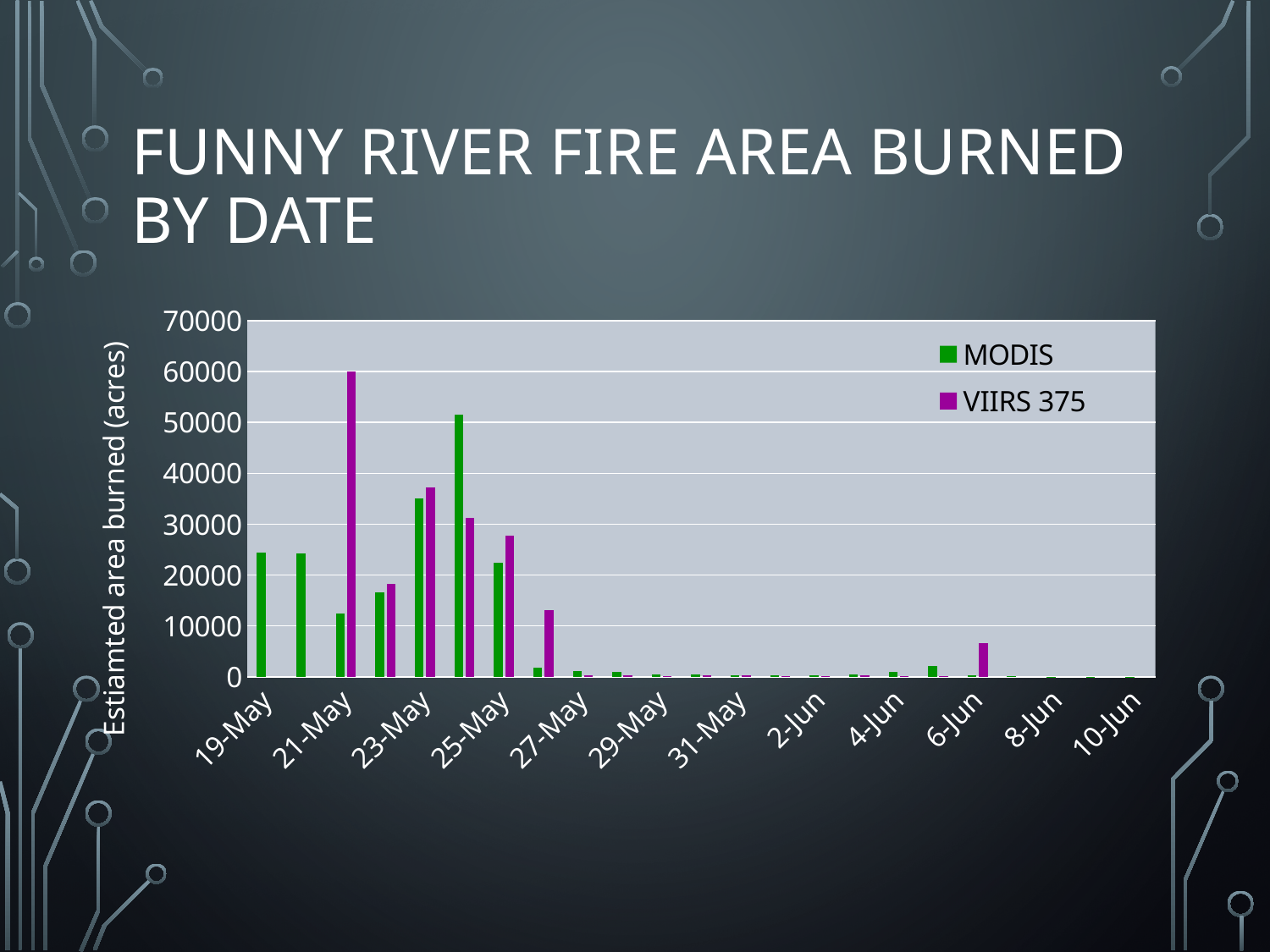
How many series does the legend list? 2 Is the MODIS value on 19-May greater or less than 20000? greater What is the label on the vertical axis? Estiamted area burned (acres) Is the VIIRS 375 value on 21-May greater or less than 50000? greater On 21-May, which series has the larger value, MODIS or VIIRS 375? VIIRS 375 What kind of chart is shown on the slide? Bar chart Is the MODIS value on 24-May greater or less than 40000? greater Do the values generally rise or fall along the x axis after 24-May? fall What are the two series named in the legend? MODIS and VIIRS 375 On which date is the VIIRS 375 bar highest? 21-May On which date is the MODIS bar highest? 24-May